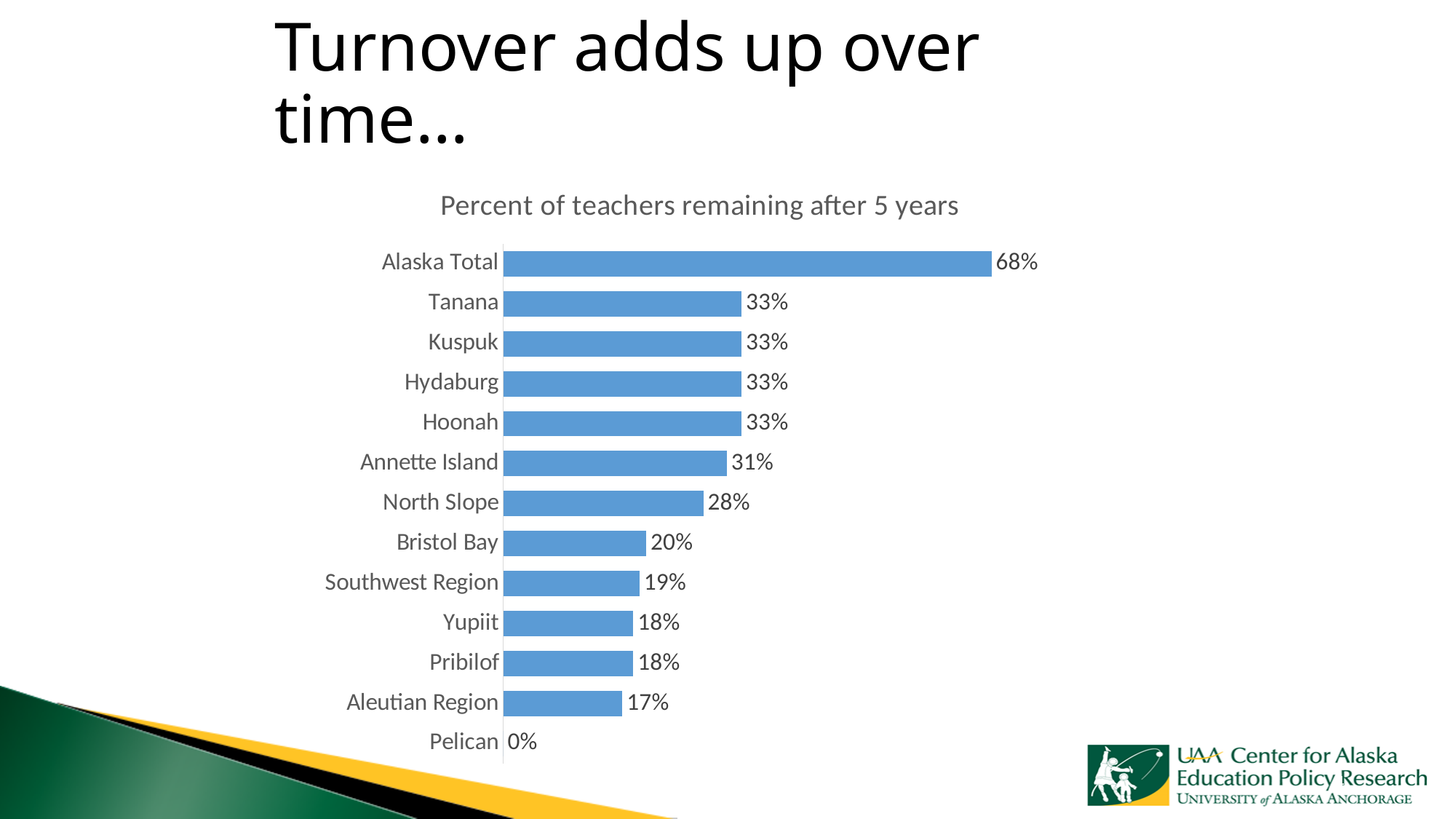
What is the difference between the values for Alaska Total and Tanana? 35% What is the difference between the values for Bristol Bay and Aleutian Region? 3% Which category has the lowest value in the chart? Pelican What is the value shown for Aleutian Region? 17% Which category has the highest value in the chart? Alaska Total What is the title of the chart? Percent of teachers remaining after 5 years Which has a larger value, North Slope or Bristol Bay? North Slope What kind of chart is shown on the slide? Bar chart How many categories are shown in the chart? 13 What is the percent of teachers remaining after 5 years for Alaska Total? 68% What is the value shown for North Slope? 28% What is the value shown for Annette Island? 31%